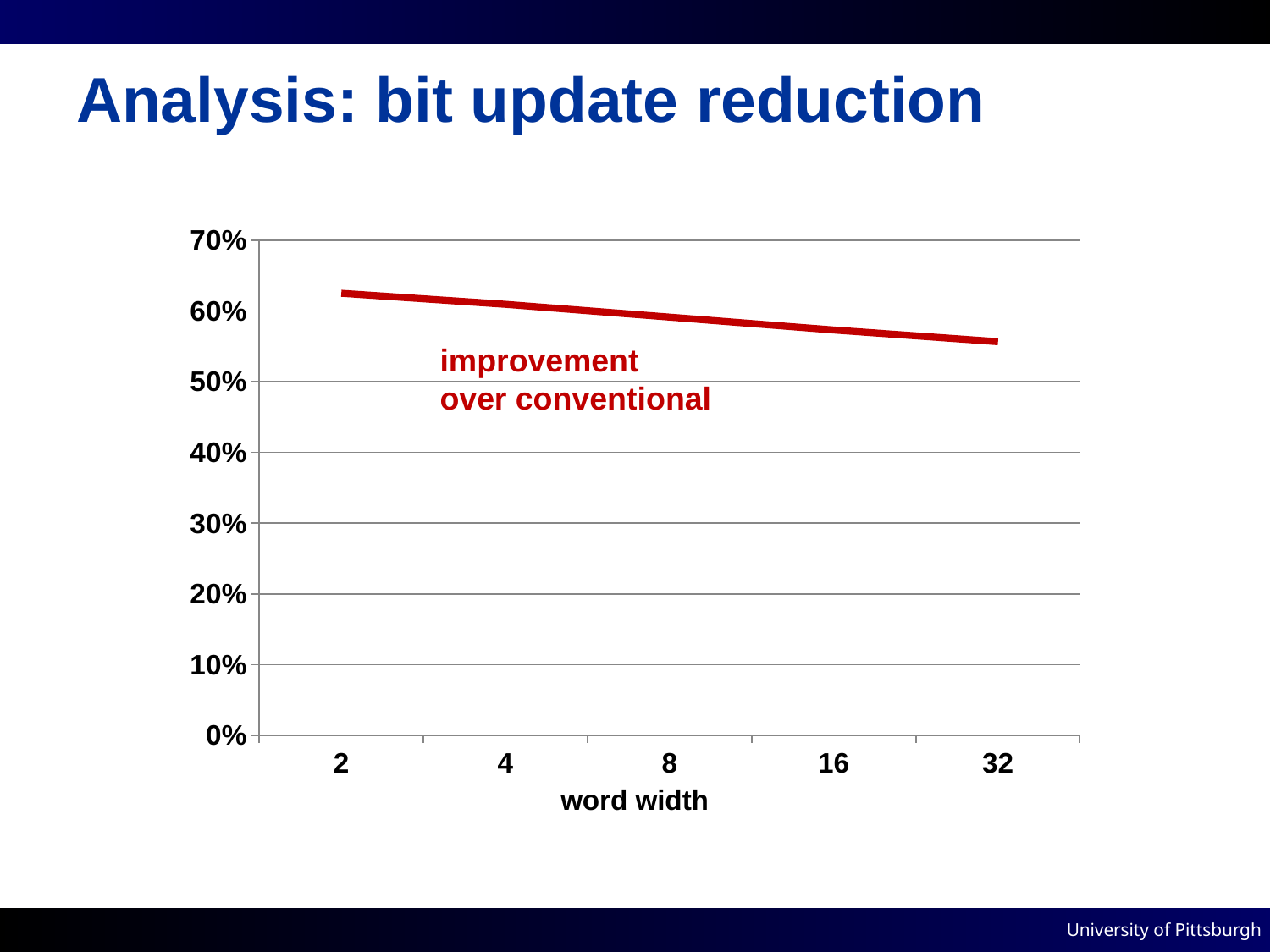
What kind of chart is shown on the slide? line chart How many word width values are plotted along the x axis? 5 What does the red text label on the chart say the line represents? improvement over conventional Is the value at word width 32 greater or less than 60%? less Is the value at word width 32 greater or less than 50%? greater At which word width is the plotted value highest? 2 Do the values rise or fall as word width increases from 2 to 32? fall What is the title of the x axis? word width Is the value at word width 2 greater or less than 70%? less At which word width is the plotted value lowest? 32 Which has the larger value: word width 2 or word width 32? word width 2